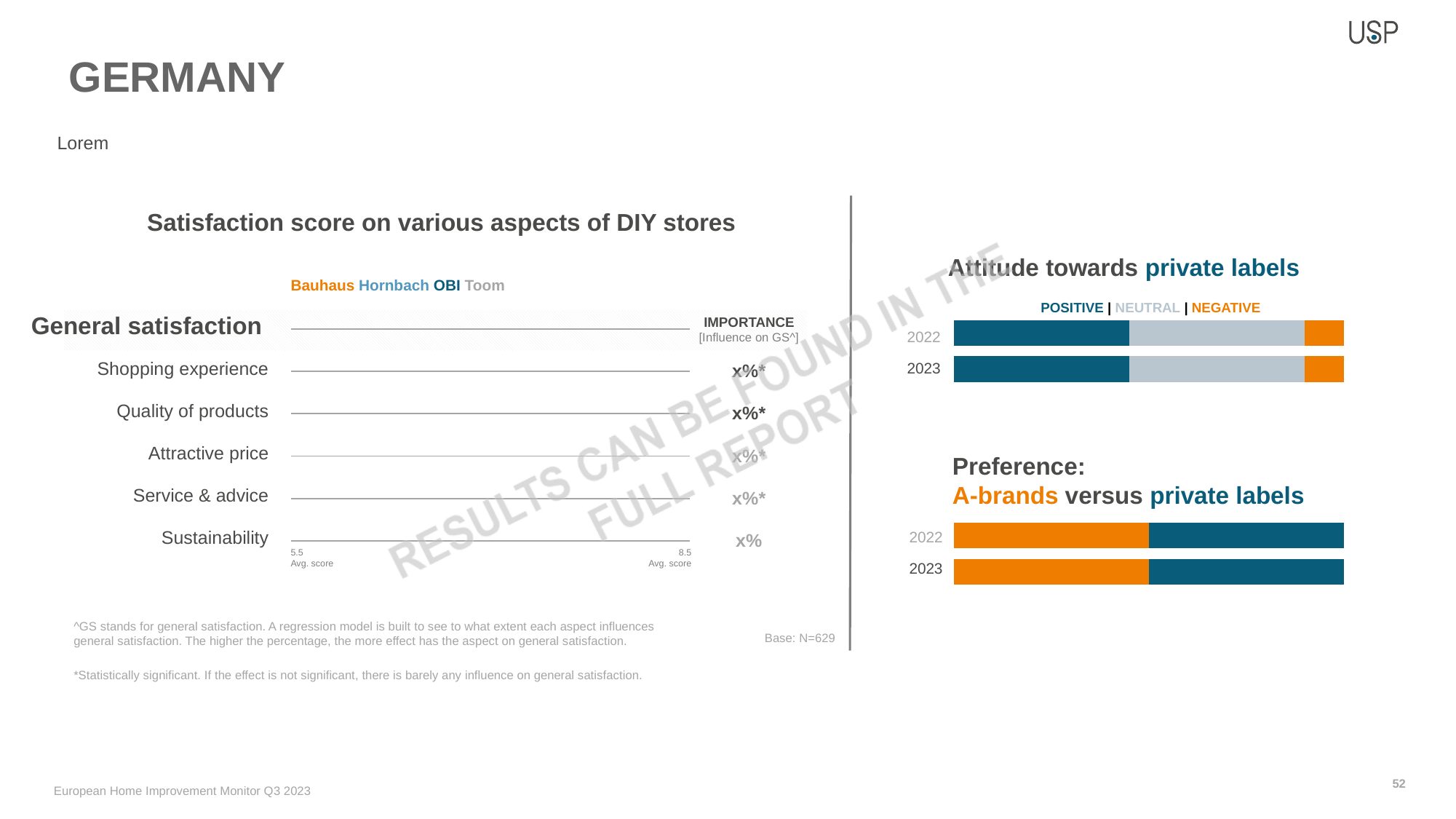
Which stores are listed in the legend of the 'Satisfaction score on various aspects of DIY stores' chart? Bauhaus, Hornbach, OBI, Toom Which series are listed in the legend of the 'Attitude towards private labels' chart? Positive, Neutral, Negative In the 'Attitude towards private labels' chart, is the Positive segment or the Negative segment larger for 2022? Positive How many series does the legend of the 'Satisfaction score on various aspects of DIY stores' chart list? 4 In the 'Attitude towards private labels' chart, which segment is the smallest in the 2023 bar? Negative What kind of chart is the 'Preference: A-brands versus private labels' chart? bar chart How many years are shown in the 'Attitude towards private labels' chart? 2 What kind of chart is the 'Attitude towards private labels' chart? bar chart How many series does the legend of the 'Attitude towards private labels' chart list? 3 How many aspects are listed below 'General satisfaction' in the 'Satisfaction score on various aspects of DIY stores' chart? 5 How many years are shown in the 'Preference: A-brands versus private labels' chart? 2